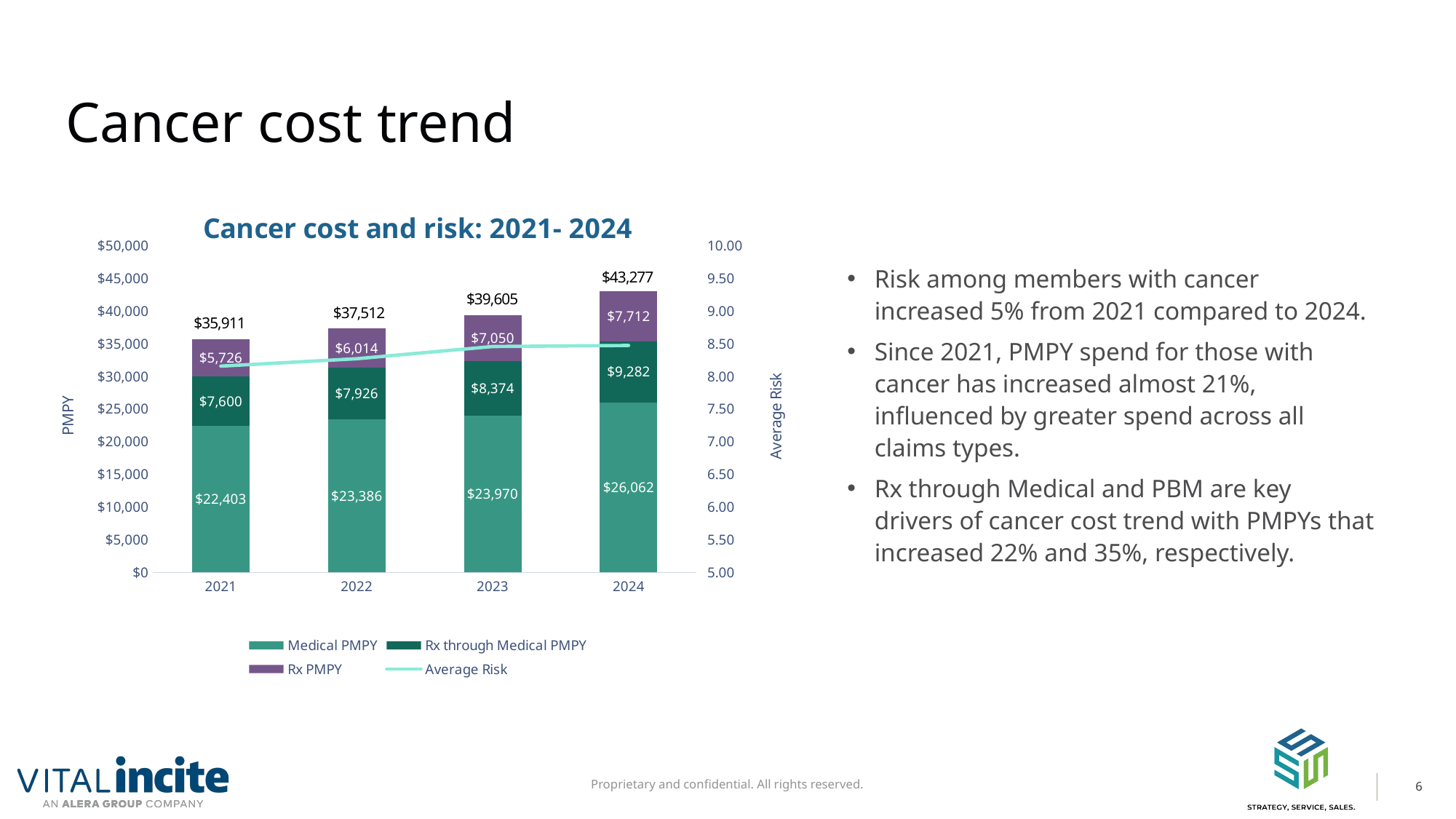
What is the Medical PMPY value for 2024? $26,062 What is the Rx PMPY value for 2021? $5,726 Which is larger: Rx through Medical PMPY in 2022 or Rx PMPY in 2023? Rx through Medical PMPY in 2022 Does the total PMPY rise or fall from 2021 to 2024? rise What is the difference between the total PMPY in 2024 and in 2021? $7,366 Which year has the lowest Medical PMPY? 2021 What is the total PMPY shown above the 2022 bar? $37,512 Which year has the highest total PMPY? 2024 What is the Rx through Medical PMPY value for 2023? $8,374 How many series does the legend list? 4 What is the difference between Rx PMPY in 2024 and Rx PMPY in 2021? $1,986 Is the Average Risk value for 2021 greater or less than 8.50? less